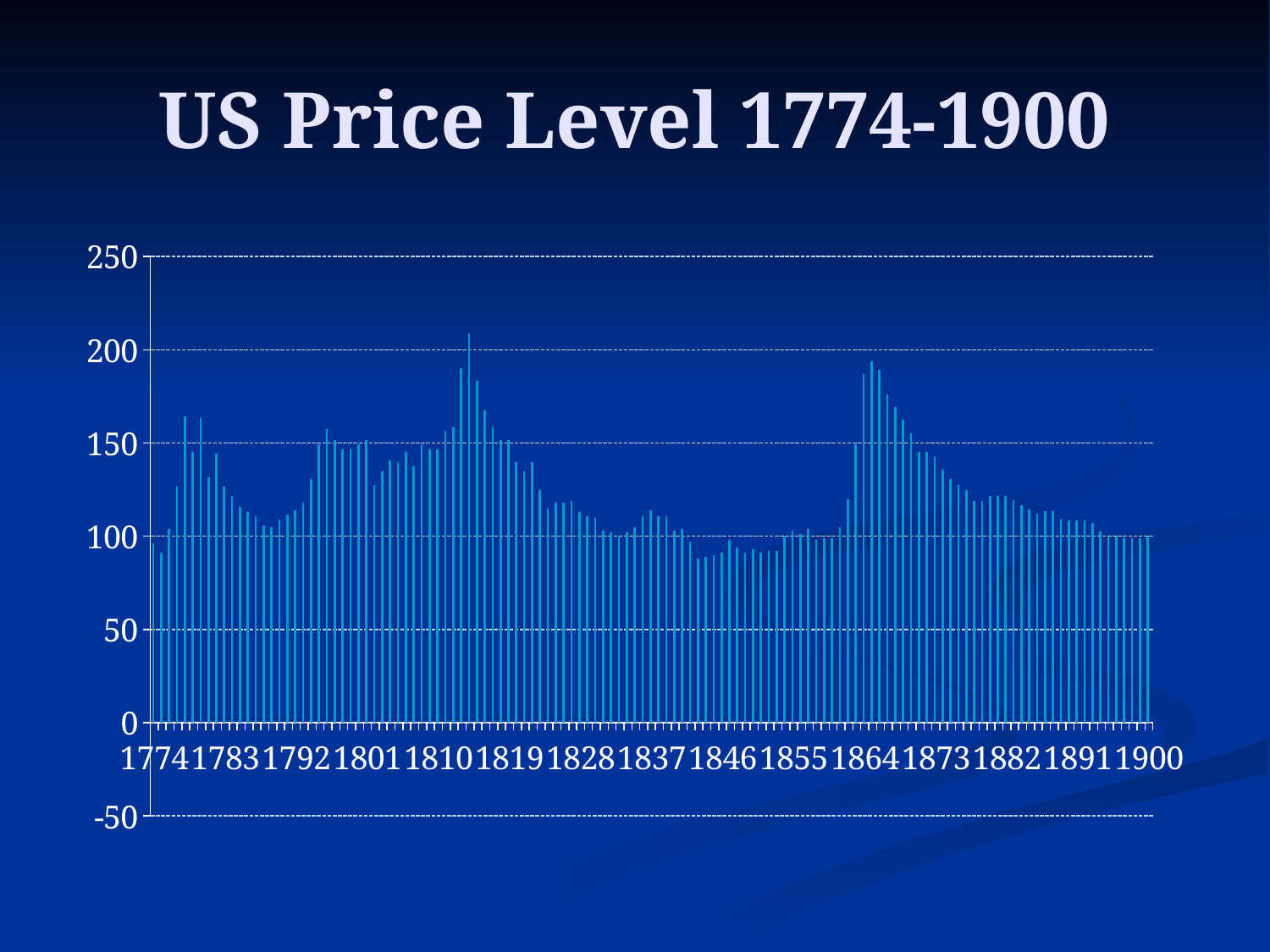
Is the value for 1774 greater or less than 100? less How many year labels are shown on the horizontal axis? 15 Is the highest value on the chart greater or less than 150? greater Which is larger, the value for 1864 or the value for 1846? 1864 Is the value for 1846 greater or less than 100? less What kind of chart is shown on the slide? bar chart What is the title of the chart? US Price Level 1774-1900 Do the values rise or fall from 1864 to 1873? fall What is the lowest value shown on the vertical axis? -50